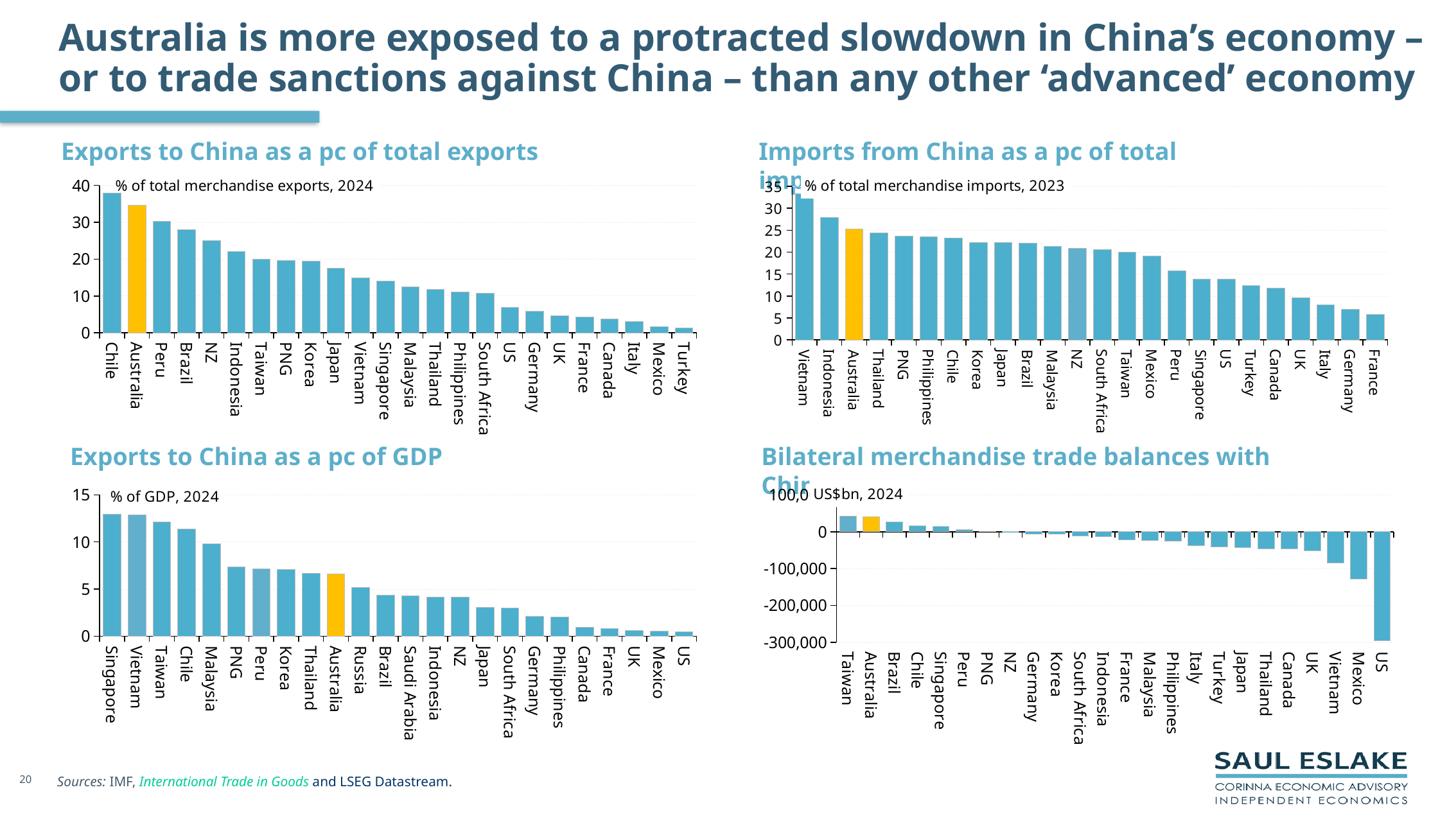
In the 'Exports to China as a pc of total exports' chart, which country has the highest value? Chile In the 'Imports from China as a pc of total imports' chart, is the value for Australia greater or less than 20? greater In the 'Imports from China as a pc of total imports' chart, which country has the highest value? Vietnam In the 'Exports to China as a pc of GDP' chart, is the value for Australia greater or less than 5? greater In the 'Exports to China as a pc of total exports' chart, is the value for Australia greater or less than 30? greater In the 'Imports from China as a pc of total imports' chart, which country has the lowest value? France In the 'Exports to China as a pc of GDP' chart, which is larger, the value for Taiwan or the value for Japan? Taiwan In the 'Exports to China as a pc of total exports' chart, how many countries are shown? 24 In the 'Exports to China as a pc of total exports' chart, do the values rise or fall from left to right? fall In the 'Bilateral merchandise trade balances with China' chart, which country has the lowest value? US What type of chart is the 'Bilateral merchandise trade balances with China' chart? bar chart In the 'Exports to China as a pc of total exports' chart, which country has the lowest value? Turkey